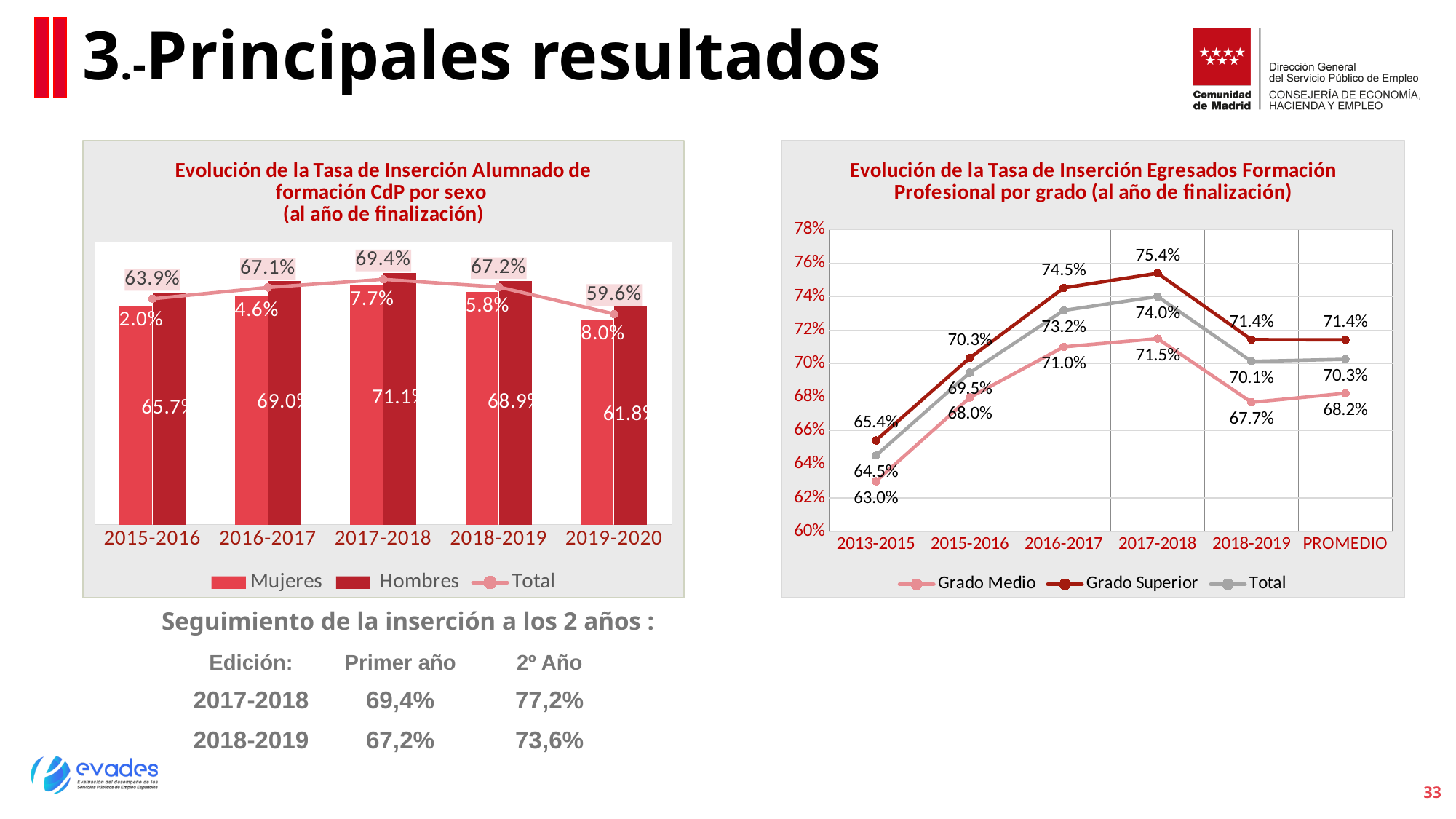
In the right chart (Evolución de la Tasa de Inserción Egresados Formación Profesional por grado), what is the Grado Medio value for 2013-2015? 63.0% In the left chart (Evolución de la Tasa de Inserción Alumnado de formación CdP por sexo), how many series does the legend list? 3 In the right chart (Evolución de la Tasa de Inserción Egresados Formación Profesional por grado), which period has the highest Total value? 2017-2018 In the left chart (Evolución de la Tasa de Inserción Alumnado de formación CdP por sexo), which period has the lowest Total value? 2019-2020 In the left chart (Evolución de la Tasa de Inserción Alumnado de formación CdP por sexo), what is the Total value for 2017-2018? 69.4% In the right chart (Evolución de la Tasa de Inserción Egresados Formación Profesional por grado), what is the Total value for PROMEDIO? 70.3% In the left chart (Evolución de la Tasa de Inserción Alumnado de formación CdP por sexo), how many periods are shown on the x axis? 5 In the left chart (Evolución de la Tasa de Inserción Alumnado de formación CdP por sexo), what is the Hombres value for 2019-2020? 61.8% What kind of chart is the right chart (Evolución de la Tasa de Inserción Egresados Formación Profesional por grado)? Line chart In the right chart (Evolución de la Tasa de Inserción Egresados Formación Profesional por grado), what is the difference between Grado Superior and Grado Medio in 2016-2017? 3.5% In the right chart (Evolución de la Tasa de Inserción Egresados Formación Profesional por grado), what is the Grado Superior value for 2017-2018? 75.4% In the left chart (Evolución de la Tasa de Inserción Alumnado de formación CdP por sexo), what is the difference between the Total values for 2017-2018 and 2019-2020? 9.8%